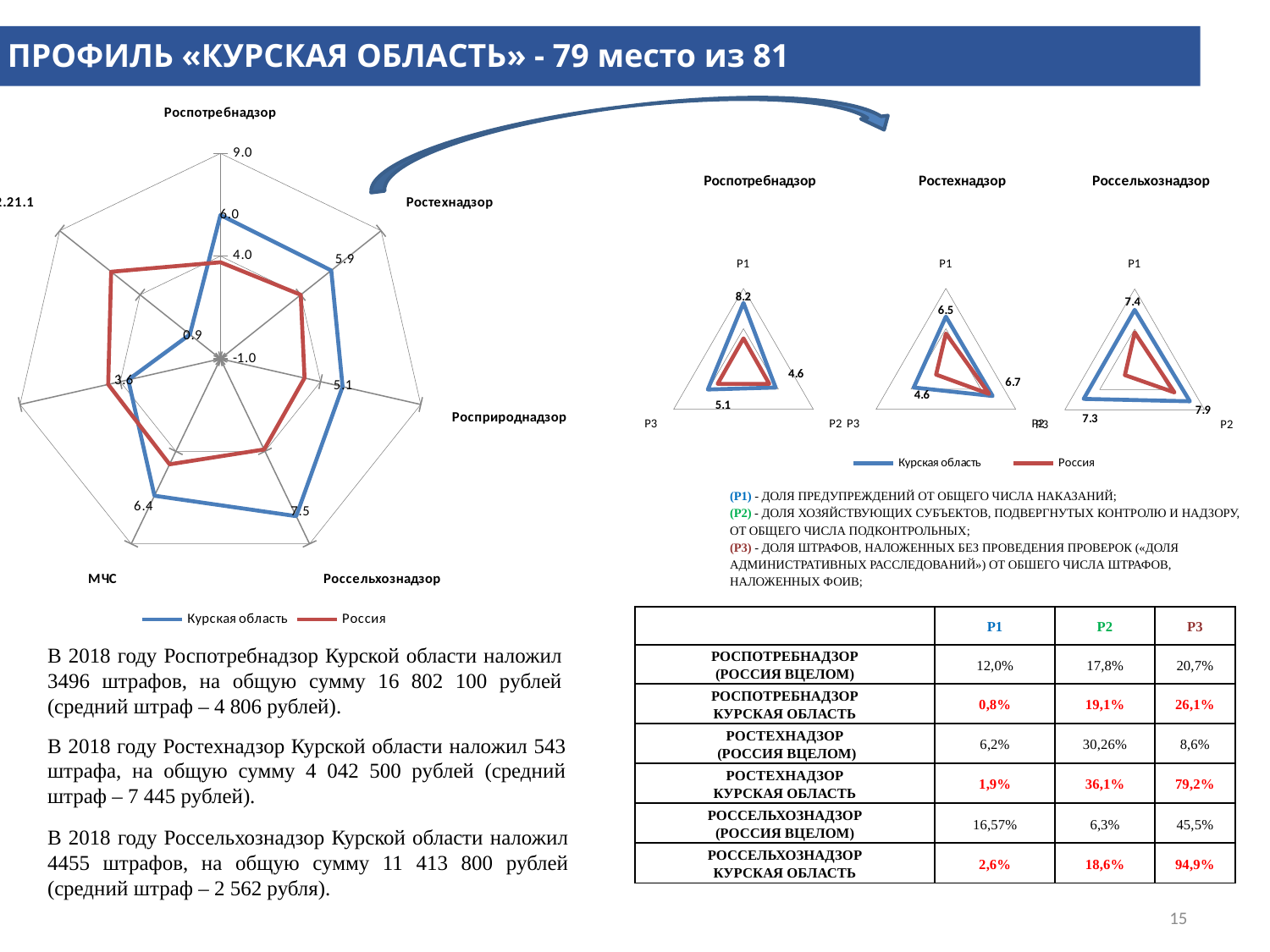
How many series does the legend of the large radar chart on the left list? 2 In the small radar chart titled Ростехнадзор, which axis has the lowest labelled value? P3 In the large radar chart on the left, what is the value for Курская область at Россельхознадзор? 7.5 In the large radar chart on the left, what is the value for Курская область at МЧС? 6.4 In the small radar chart titled Россельхознадзор, what is the labelled value at P2? 7.9 In the large radar chart on the left, which is larger for Курская область: the value at Роспотребнадзор or at Росприроднадзор? Роспотребнадзор In the large radar chart on the left, at which labelled axis does Курская область have its highest value? Россельхознадзор In the large radar chart on the left, what is the difference between the Курская область values at Россельхознадзор and МЧС? 1.1 In the large radar chart on the left, what is the value for Курская область at Ростехнадзор? 5.9 What kind of chart is the large chart on the left of the slide? radar chart In the small radar chart titled Роспотребнадзор, what is the labelled value at P1? 8.2 How many small radar charts are shown on the right side of the slide? 3